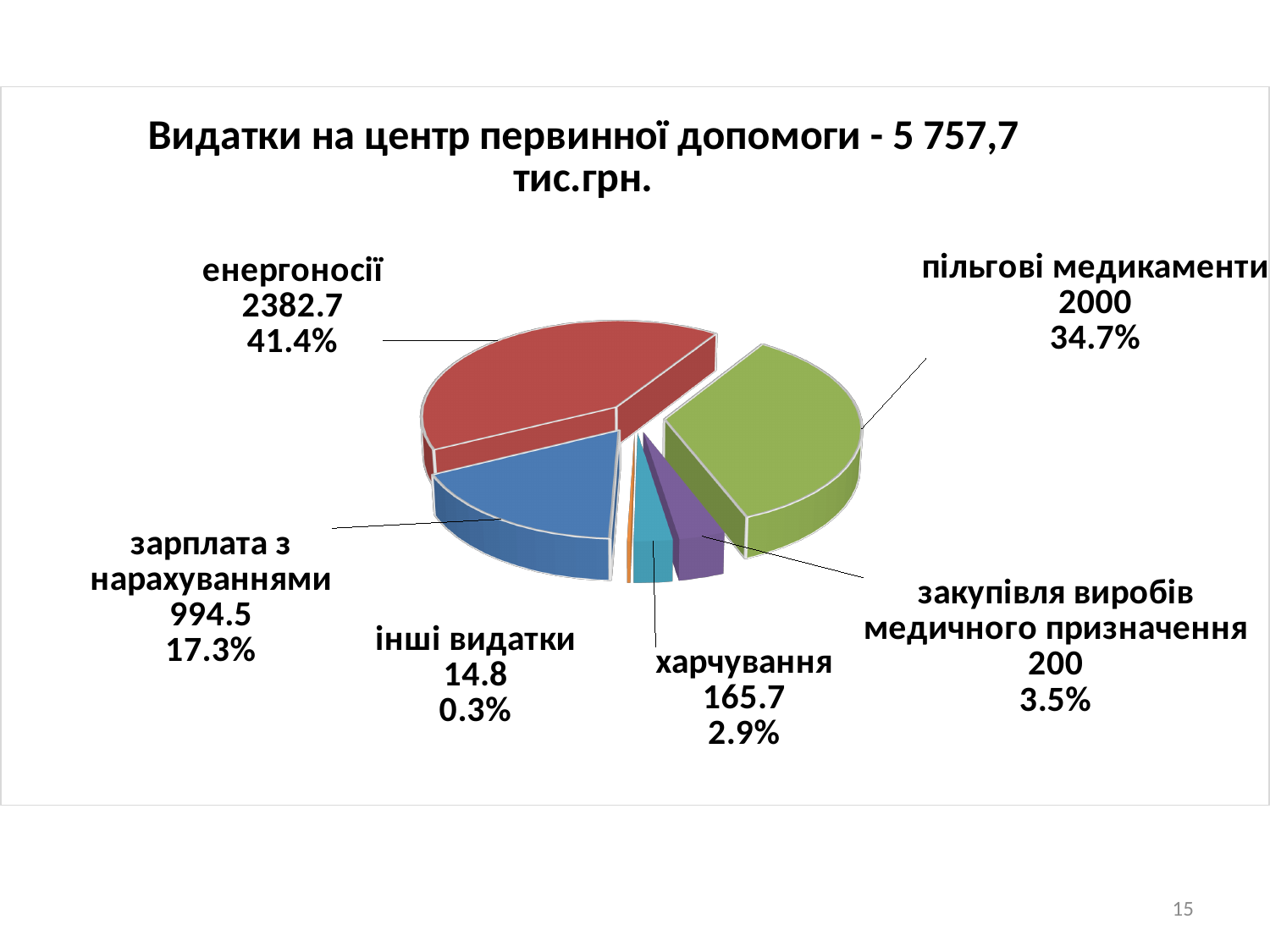
What kind of chart is shown on the slide? pie chart What is the value for зарплата з нарахуваннями? 994.5 What share of the pie does інші видатки represent? 0.3% What is the value for енергоносії? 2382.7 How many categories are shown in the pie chart? 6 Which is larger, the value for харчування or the value for закупівля виробів медичного призначення? закупівля виробів медичного призначення What is the difference between the values for енергоносії and пільгові медикаменти? 382.7 What is the value for пільгові медикаменти? 2000 What share of the pie does закупівля виробів медичного призначення represent? 3.5% Which category has the largest slice? енергоносії What is the value for харчування? 165.7 Which category has the smallest slice? інші видатки